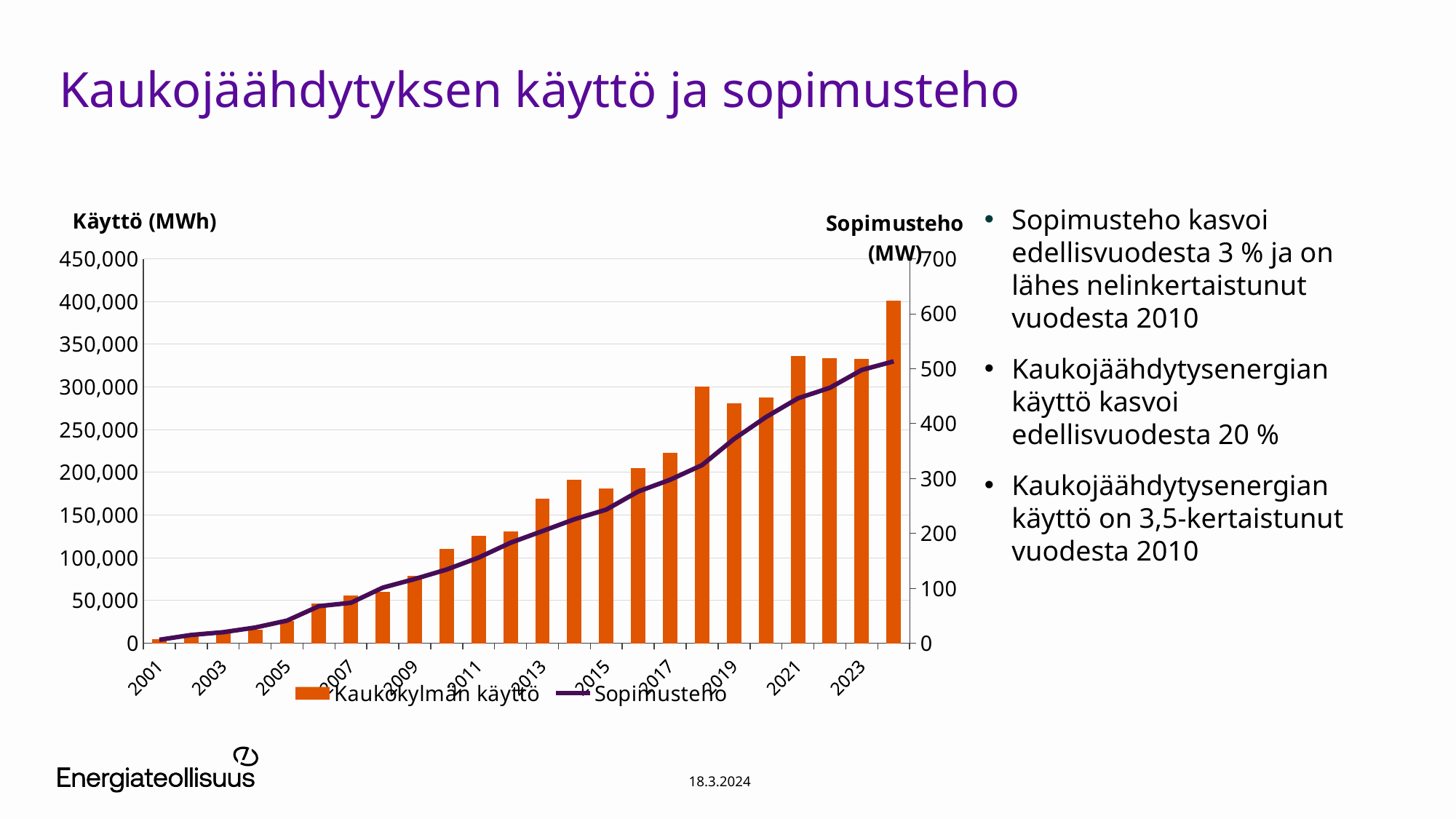
Is the Kaukokylmän käyttö value for 2005 greater or less than 50,000? less What is the title of the left vertical axis? Käyttö (MWh) Does the Sopimusteho line generally rise or fall from 2001 to the end of the series? rise How many series does the legend list? 2 How many bars are plotted in the chart? 24 Which is larger, the Kaukokylmän käyttö value for 2017 or for 2019? 2019 Is the Kaukokylmän käyttö value for 2015 greater or less than 200,000? less Which year has the lowest Kaukokylmän käyttö bar? 2001 Is the Kaukokylmän käyttö value for 2019 greater or less than 250,000? greater What are the two series named in the legend? Kaukokylmän käyttö and Sopimusteho What kind of chart is shown on the slide? bar chart with a line